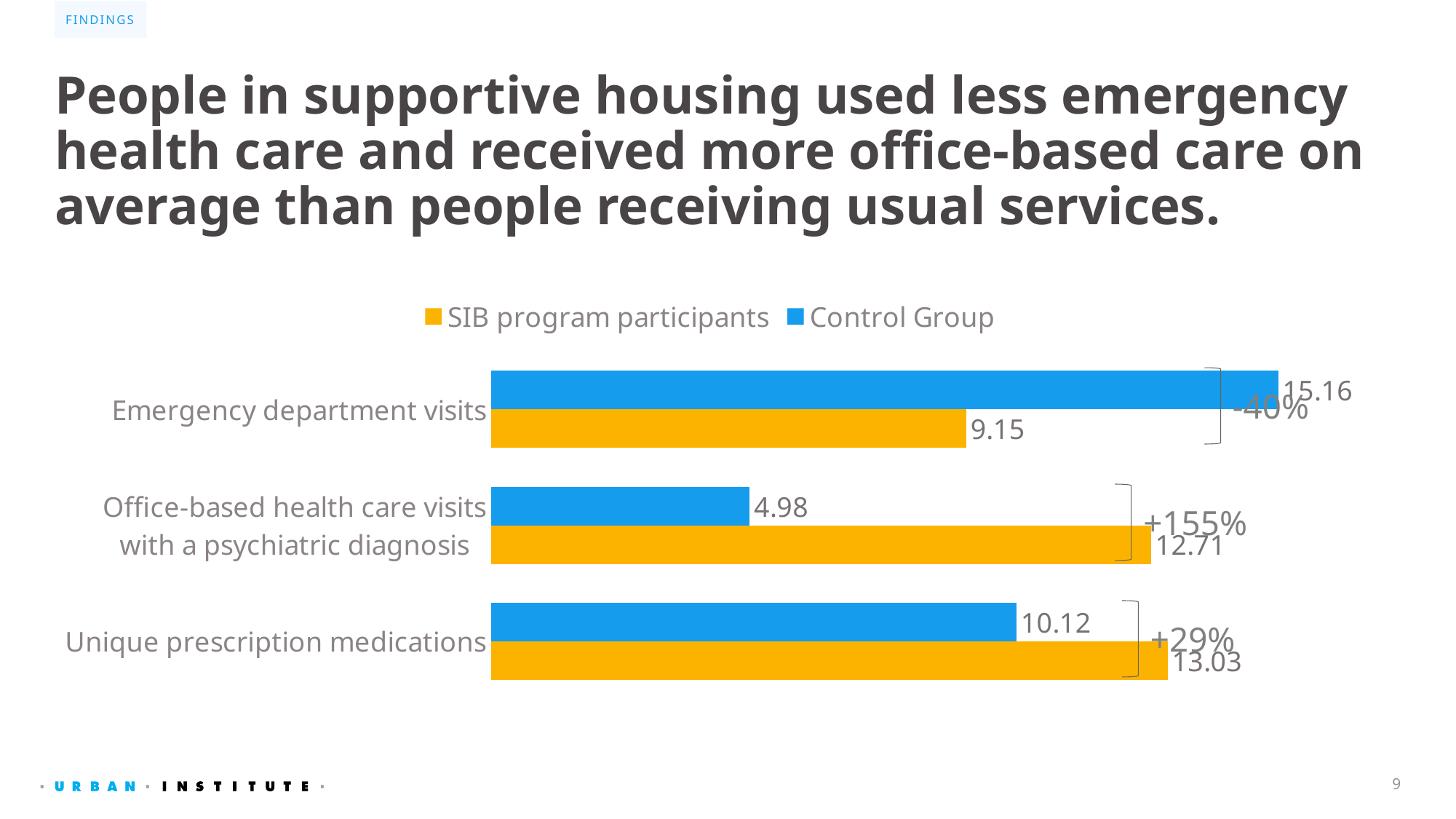
What is the value for the Control Group for Emergency department visits? 15.16 What is the value for SIB program participants for Emergency department visits? 9.15 What percentage change is annotated next to the Office-based health care visits with a psychiatric diagnosis bars? +155% What is the value for SIB program participants for Unique prescription medications? 13.03 Which category has the highest value for SIB program participants? Unique prescription medications What is the difference between the Control Group and SIB program participants for Emergency department visits? 6.01 For Unique prescription medications, which group has the larger value, SIB program participants or the Control Group? SIB program participants Which category has the lowest value for the Control Group? Office-based health care visits with a psychiatric diagnosis What kind of chart is shown on the slide? Bar chart How many categories are shown on the chart? 3 How many series does the legend list? 2 What is the value for the Control Group for Office-based health care visits with a psychiatric diagnosis? 4.98